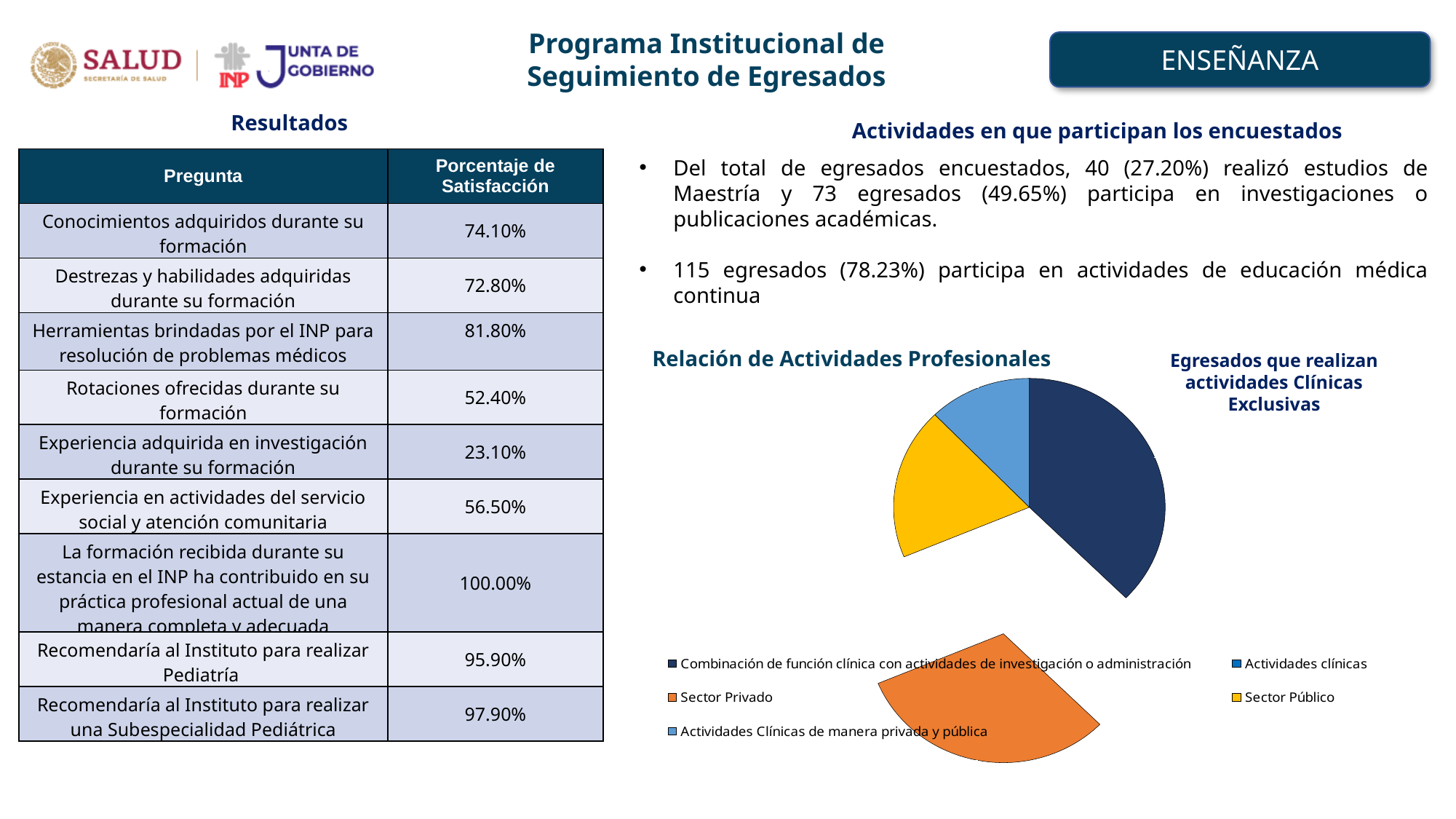
In the 'Relación de Actividades Profesionales' pie chart, what colour is the slice for 'Sector Público'? yellow In the 'Relación de Actividades Profesionales' pie chart, which is larger: the slice for 'Sector Público' or the slice for 'Actividades Clínicas de manera privada y pública'? Sector Público In the 'Relación de Actividades Profesionales' pie chart, which category has the largest slice? Combinación de función clínica con actividades de investigación o administración What kind of chart is 'Relación de Actividades Profesionales'? pie chart In the 'Relación de Actividades Profesionales' pie chart, what colour is the slice for 'Sector Privado'? orange In the 'Relación de Actividades Profesionales' pie chart, which legend category is shown in dark navy blue? Combinación de función clínica con actividades de investigación o administración How many entries does the legend of the 'Relación de Actividades Profesionales' pie chart list? 5 In the 'Relación de Actividades Profesionales' pie chart, which is larger: the slice for 'Combinación de función clínica con actividades de investigación o administración' or the slice for 'Sector Público'? Combinación de función clínica con actividades de investigación o administración